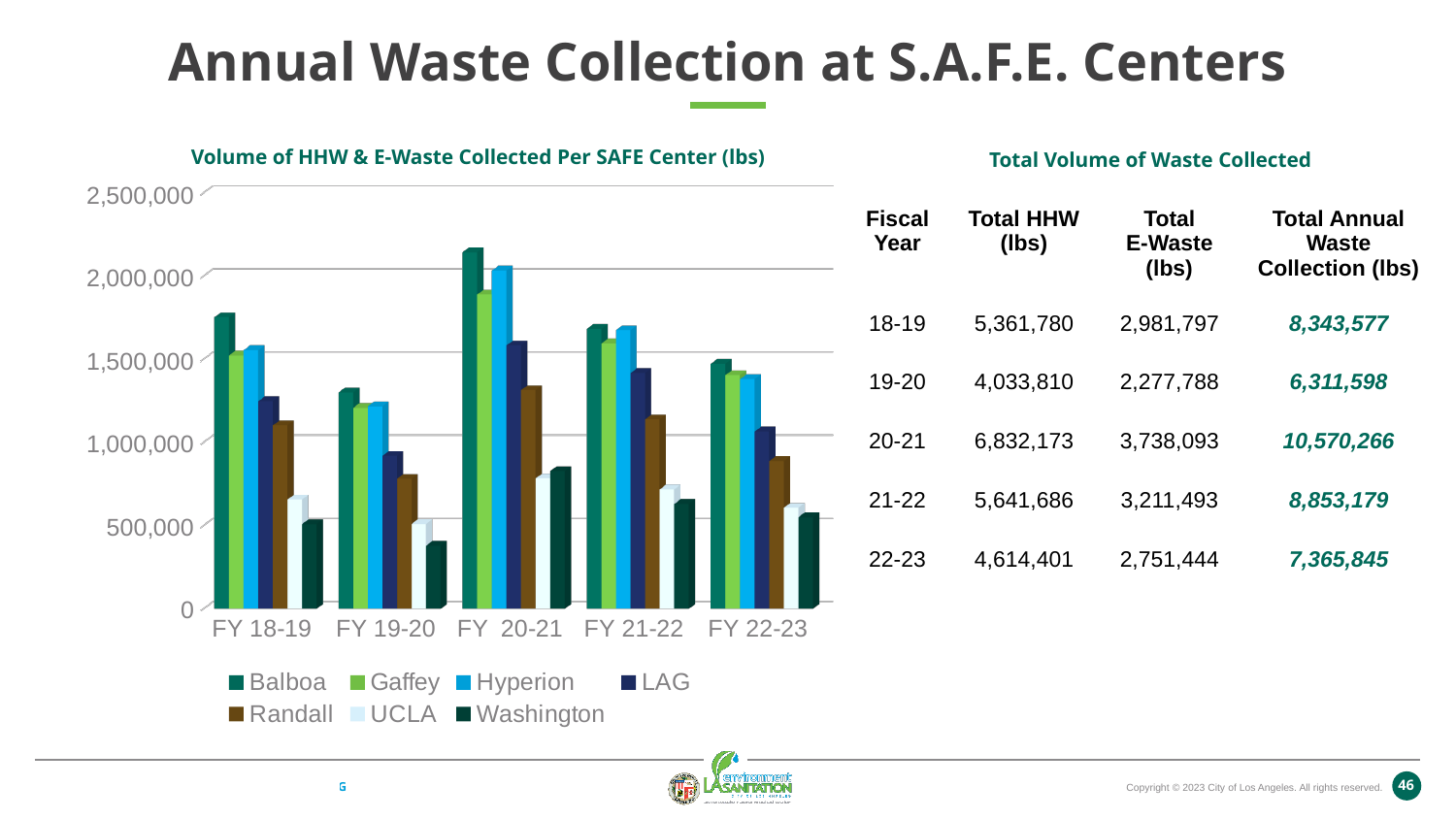
How many series does the chart's legend list? 7 What is the title of the chart? Volume of HHW & E-Waste Collected Per SAFE Center (lbs) How many fiscal years are shown on the x axis of the chart? 5 In which fiscal year is the Balboa bar the tallest? FY 20-21 In FY 20-21, which is larger: the Randall bar or the UCLA bar? Randall Is the value for Balboa in FY 20-21 greater or less than 2,000,000? greater Does the Balboa value rise or fall from FY 18-19 to FY 19-20? fall Which center has the lowest bar in FY 19-20? Washington Is the value for LAG in FY 18-19 greater or less than 1,000,000? greater In FY 18-19, which is larger: the Balboa bar or the Washington bar? Balboa Is the value for Washington in FY 19-20 greater or less than 500,000? less What kind of chart is shown on the slide? Bar chart